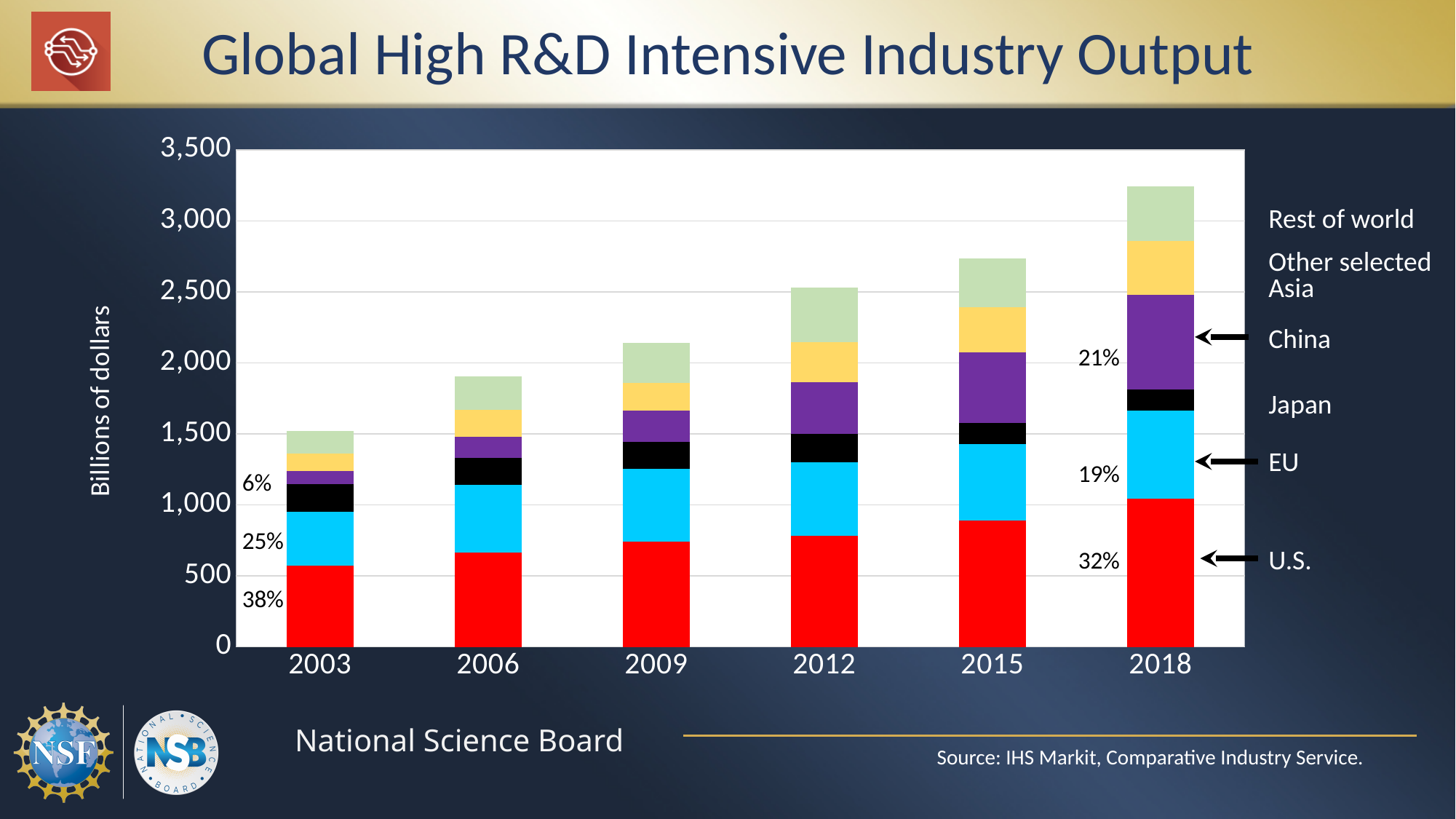
What share of global high R&D intensive industry output did the U.S. have in 2003? 38% In 2018, which had the larger share, China or the EU? China What was the EU's share in 2018? 19% Which year has the highest total output? 2018 What kind of chart is shown on the slide? Stacked bar chart By how many percentage points did China's share increase from 2003 to 2018? 15 percentage points How many series (regions) does the chart's legend list? 6 What was China's share in 2003? 6% Is the total output in 2018 greater or less than 3,000 billion dollars? greater What share of global high R&D intensive industry output did China have in 2018? 21% What was the EU's share in 2003? 25% How many years are shown along the x axis? 6